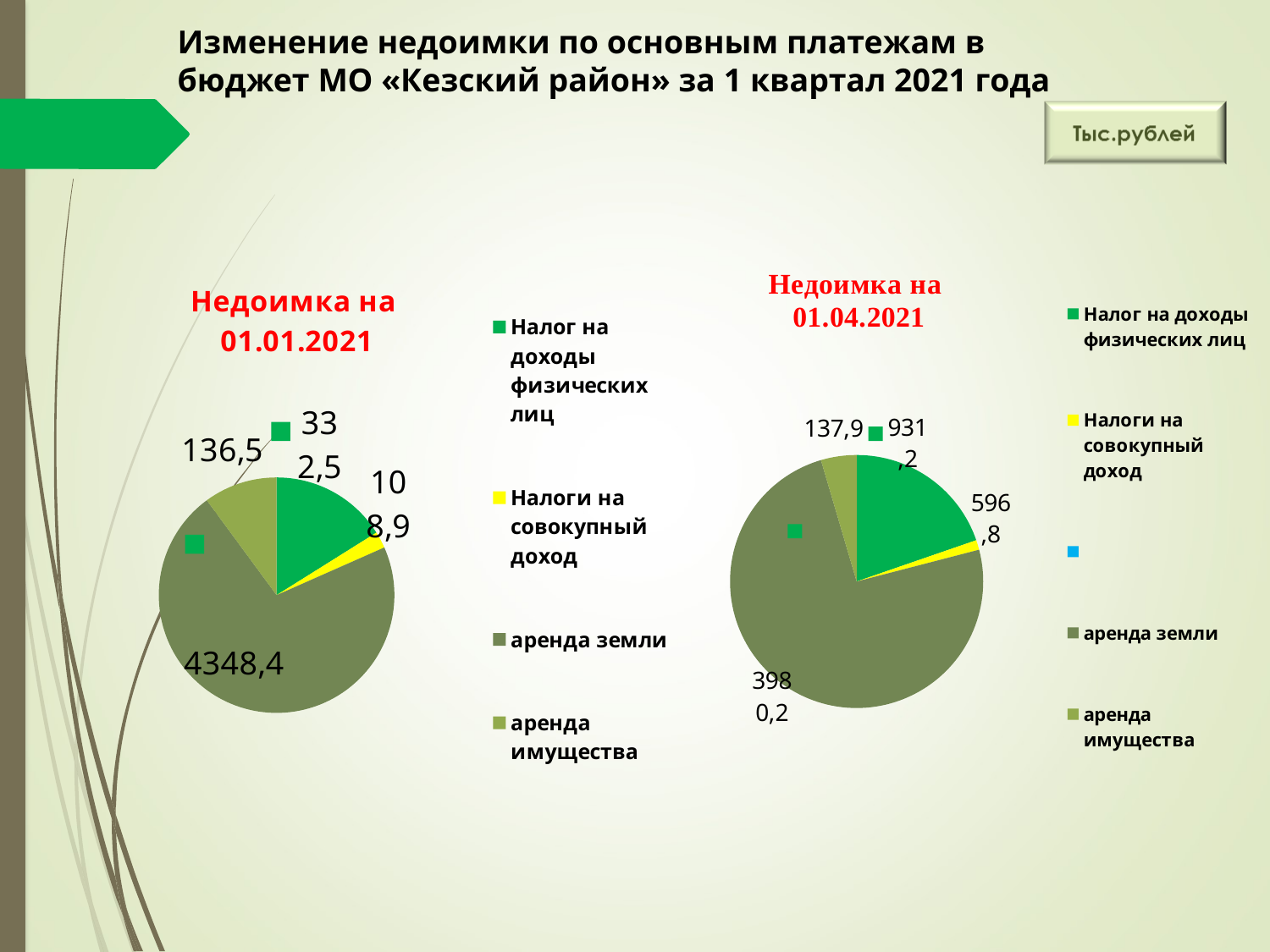
What kind of chart is used for "Недоимка на 01.01.2021"? Pie chart In the chart "Недоимка на 01.04.2021", which category has the smallest slice? Налоги на совокупный доход How many slices does the chart "Недоимка на 01.01.2021" have? 4 In the chart "Недоимка на 01.01.2021", what is the value for аренда имущества? 136,5 In the chart "Недоимка на 01.04.2021", what is the value for Налоги на совокупный доход? 596,8 In the chart "Недоимка на 01.01.2021", which category has the smallest slice? Налоги на совокупный доход In the chart "Недоимка на 01.04.2021", what is the difference between аренда земли and Налог на доходы физических лиц? 3049 In the chart "Недоимка на 01.04.2021", what is the value for аренда земли? 3980,2 In the chart "Недоимка на 01.01.2021", which category has the largest slice? аренда земли In the chart "Недоимка на 01.01.2021", what is the value for аренда земли? 4348,4 In the chart "Недоимка на 01.04.2021", what is the value for Налог на доходы физических лиц? 931,2 In the chart "Недоимка на 01.04.2021", what is the value for аренда имущества? 137,9